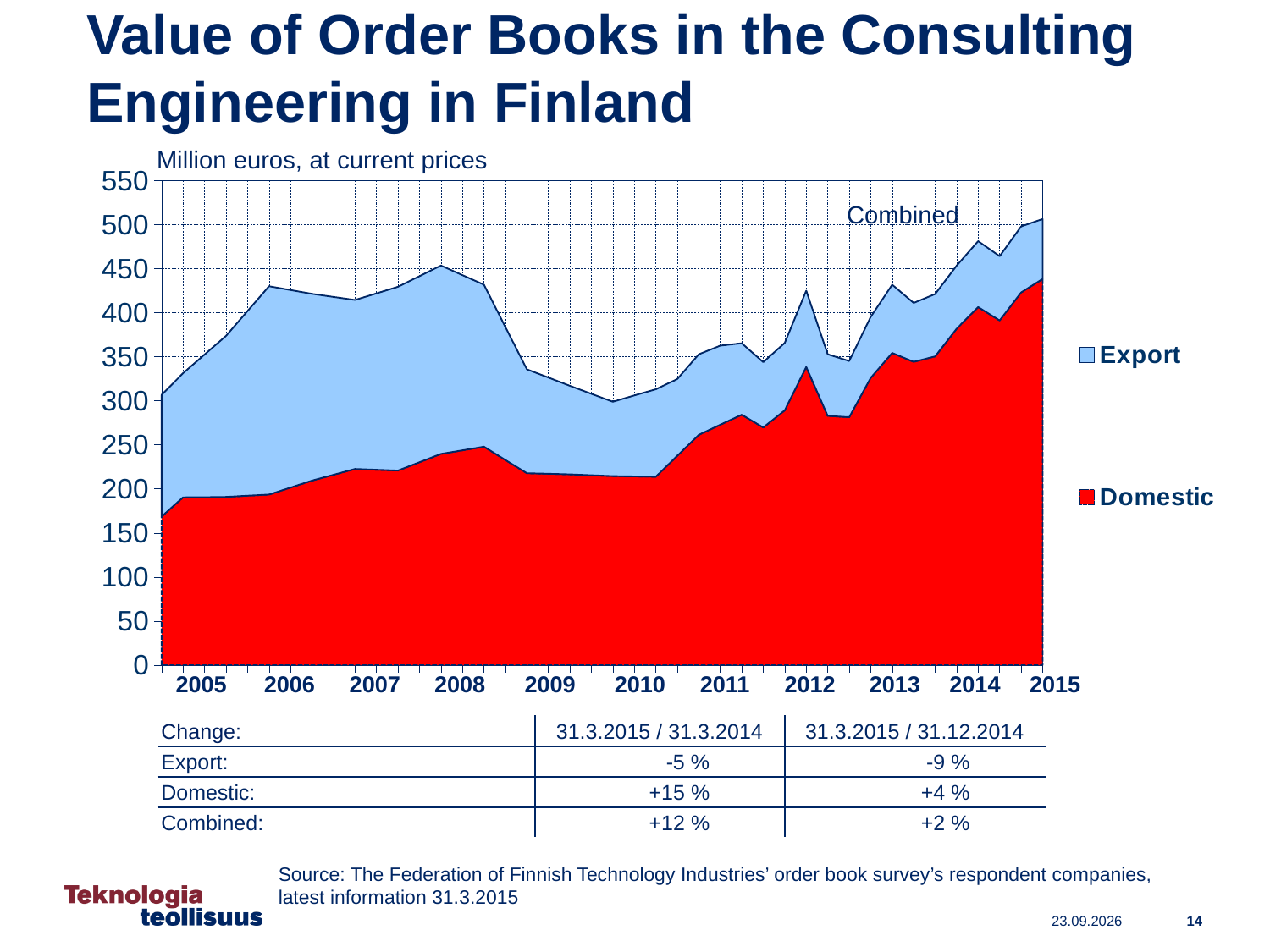
How many series does the chart legend list? 2 Which two series are listed in the chart legend? Export and Domestic Is the Domestic value in 2010 greater or less than 200? greater Is the Domestic value at the end of the series in 2015 greater or less than 400? greater What unit is stated above the chart for the values? Million euros, at current prices How many year labels are shown on the x axis? 11 Is the Combined value in 2006 greater or less than 400? greater In 2015, which series has the larger value, Export or Domestic? Domestic Does the Domestic series rise or fall from 2010 to 2015? rise What kind of chart is shown on the slide? Stacked area chart